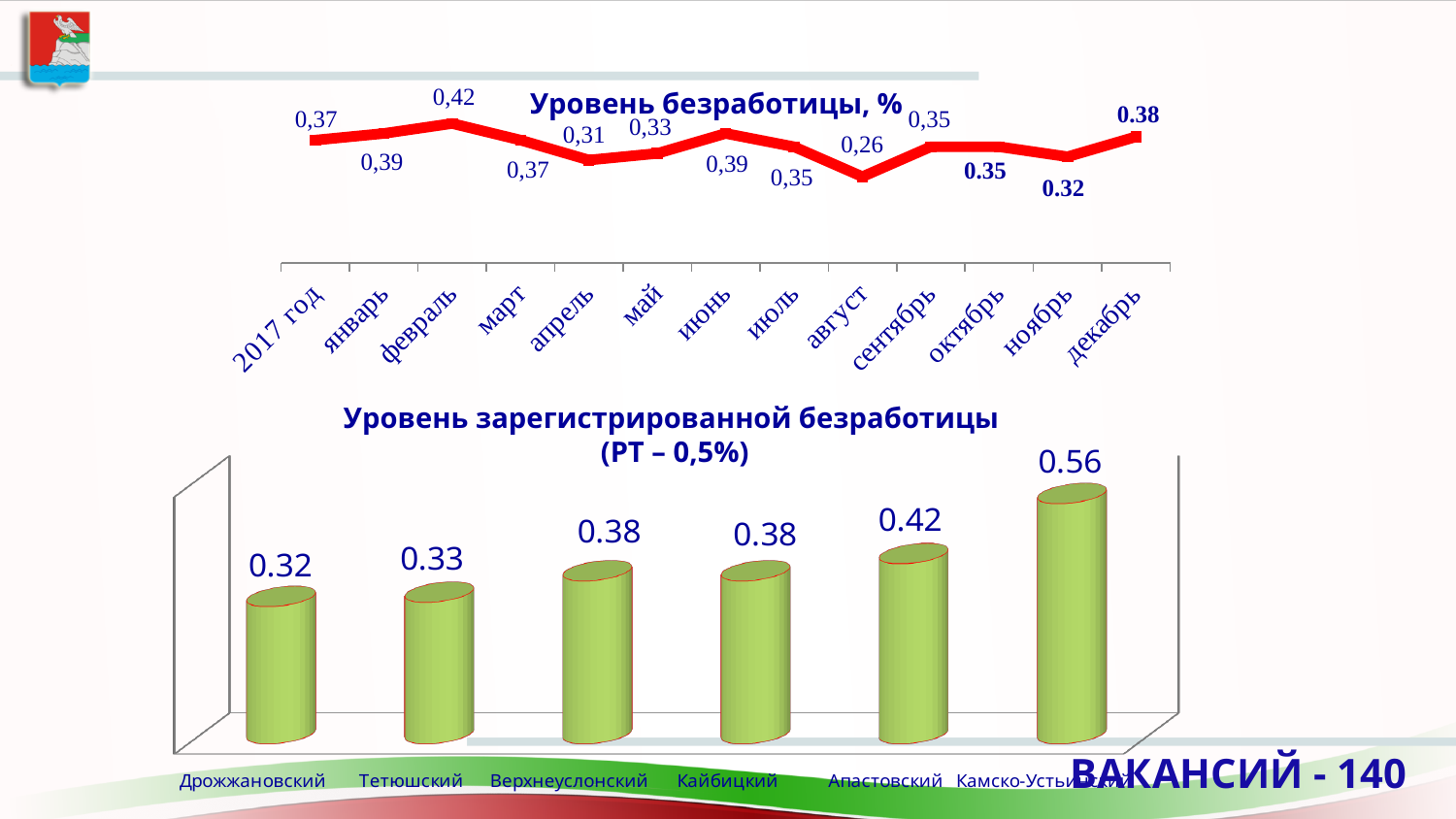
In the chart titled 'Уровень безработицы, %', how many points are plotted along the x axis? 13 In the chart titled 'Уровень зарегистрированной безработицы', how many bars are shown? 6 In the chart titled 'Уровень зарегистрированной безработицы', which category has the lowest value? Дрожжановский In the chart titled 'Уровень зарегистрированной безработицы', what is the value of the rightmost (highest) bar? 0.56 In the chart titled 'Уровень зарегистрированной безработицы', what is the value for Апастовский? 0.42 In the chart titled 'Уровень безработицы, %', what is the value for август? 0,26 In the chart titled 'Уровень безработицы, %', what is the difference between the values for февраль and август? 0,16 In the chart titled 'Уровень безработицы, %', what kind of chart is it? line chart In the chart titled 'Уровень безработицы, %', what is the value for февраль? 0,42 In the chart titled 'Уровень зарегистрированной безработицы', which is larger, the value for Тетюшский or the value for Апастовский? Апастовский In the chart titled 'Уровень безработицы, %', which month has the lowest value? август In the chart titled 'Уровень безработицы, %', which month has the highest value? февраль